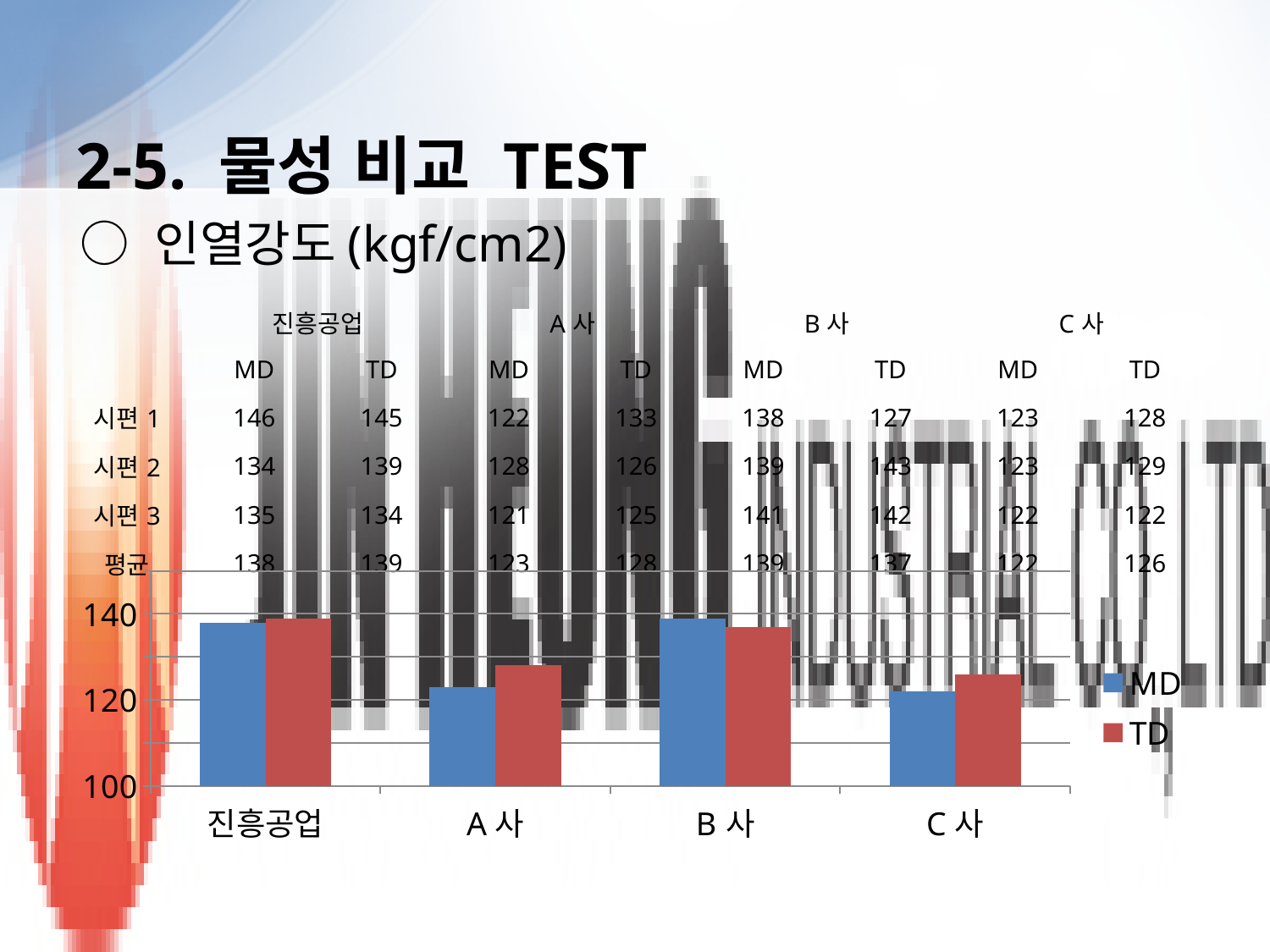
Is the TD value for 진흥공업 greater or less than 120? greater Which has the larger TD value, B 사 or C 사? B 사 Is the MD value for C 사 greater or less than 140? less How many series does the chart legend list? 2 Is the MD value for B 사 greater or less than 120? greater According to the 평균 row of the table above the chart, what is the TD average for C 사? 126 How many categories are shown on the x axis of the chart? 4 Which has the larger MD value, 진흥공업 or A 사? 진흥공업 What are the two series named in the chart legend? MD and TD According to the 평균 row of the table above the chart, what is the MD average for 진흥공업? 138 What kind of chart is shown on the slide? bar chart